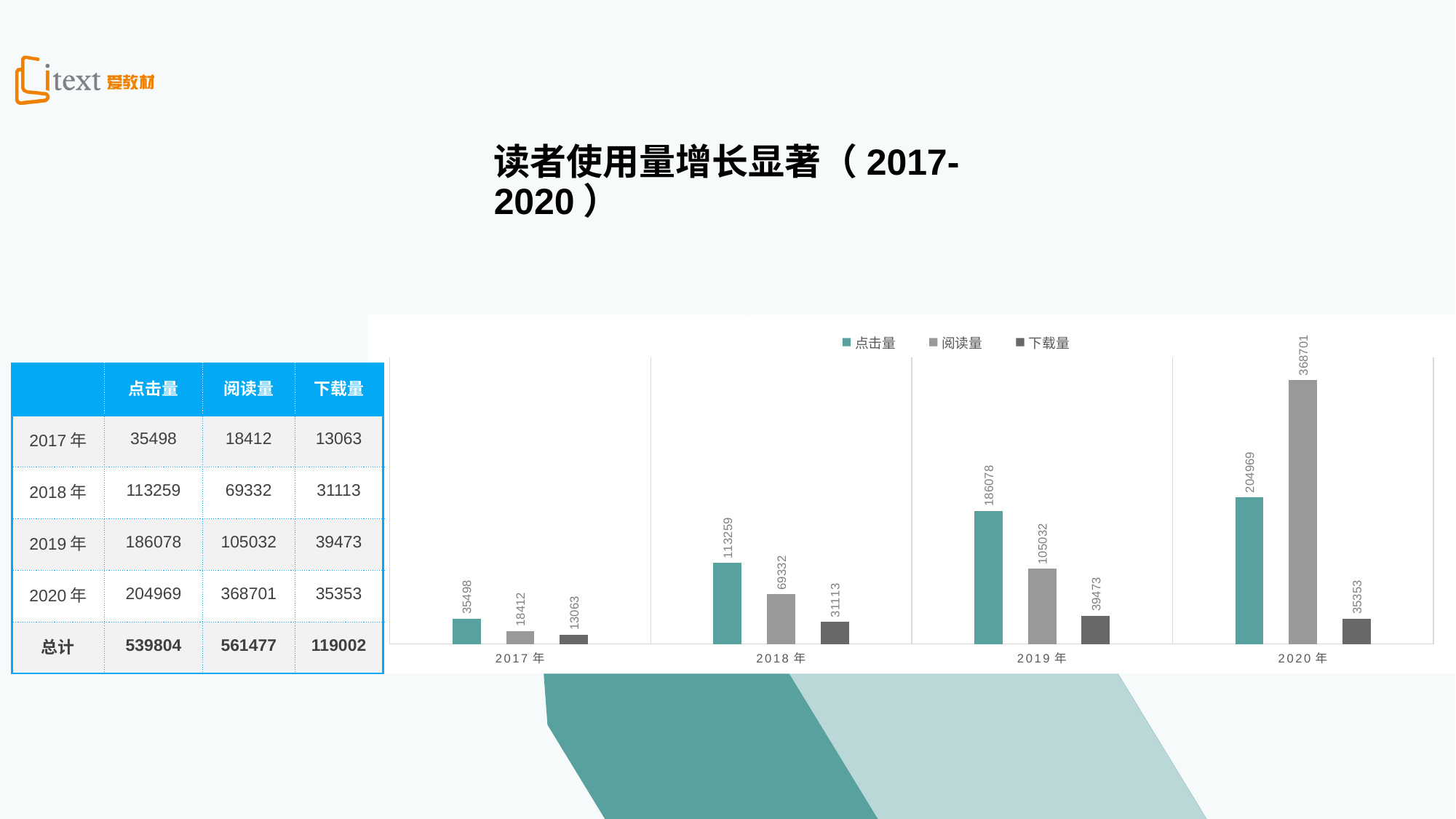
What is the value of 点击量 for 2018 年? 113259 How many years are shown on the x axis? 4 How many series does the legend list? 3 Which year has the lowest 阅读量? 2017 年 What is the difference between 阅读量 and 点击量 in 2020 年? 163732 Does 点击量 rise or fall from 2017 年 to 2020 年? rise What colour are the 点击量 bars? teal Which is larger in 2019 年, 点击量 or 阅读量? 点击量 Which year has the highest 点击量? 2020 年 What is the value of 阅读量 for 2020 年? 368701 What is the value of 下载量 for 2019 年? 39473 What kind of chart is shown? bar chart